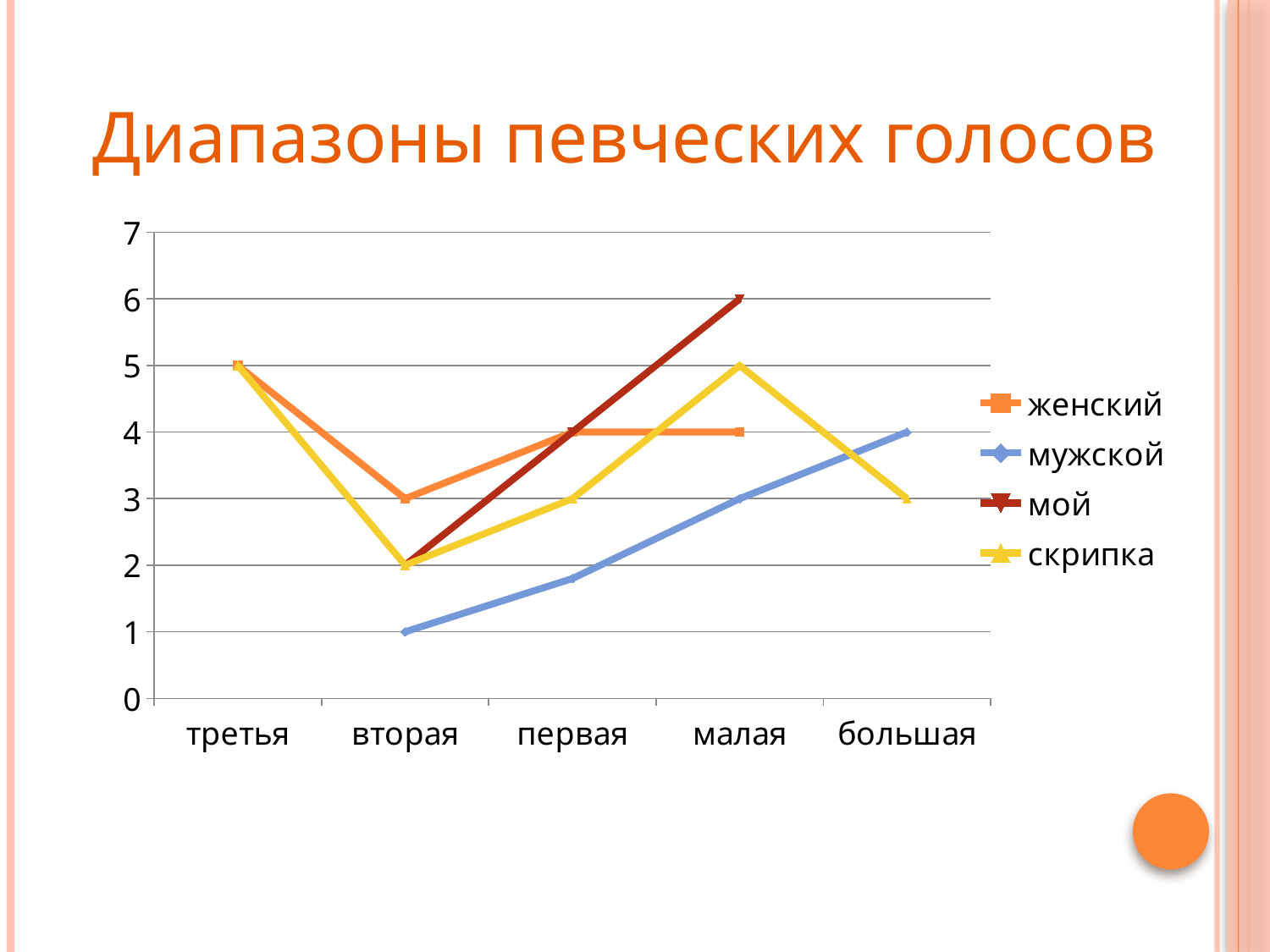
Is the value of the мужской series at первая greater or less than 2? less How many series does the legend list? 4 At вторая, which series has the larger value, женский or скрипка? женский What is the title of the slide? Диапазоны певческих голосов What is the value of the женский series at третья? 5 What kind of chart is shown on the slide? line chart What is the difference between the женский values at третья and вторая? 2 Does the мужской series rise or fall from вторая to большая? rise Which series has the highest value at малая? мой How many categories are on the x axis? 5 What is the value of the мужской series at большая? 4 What is the value of the скрипка series at малая? 5